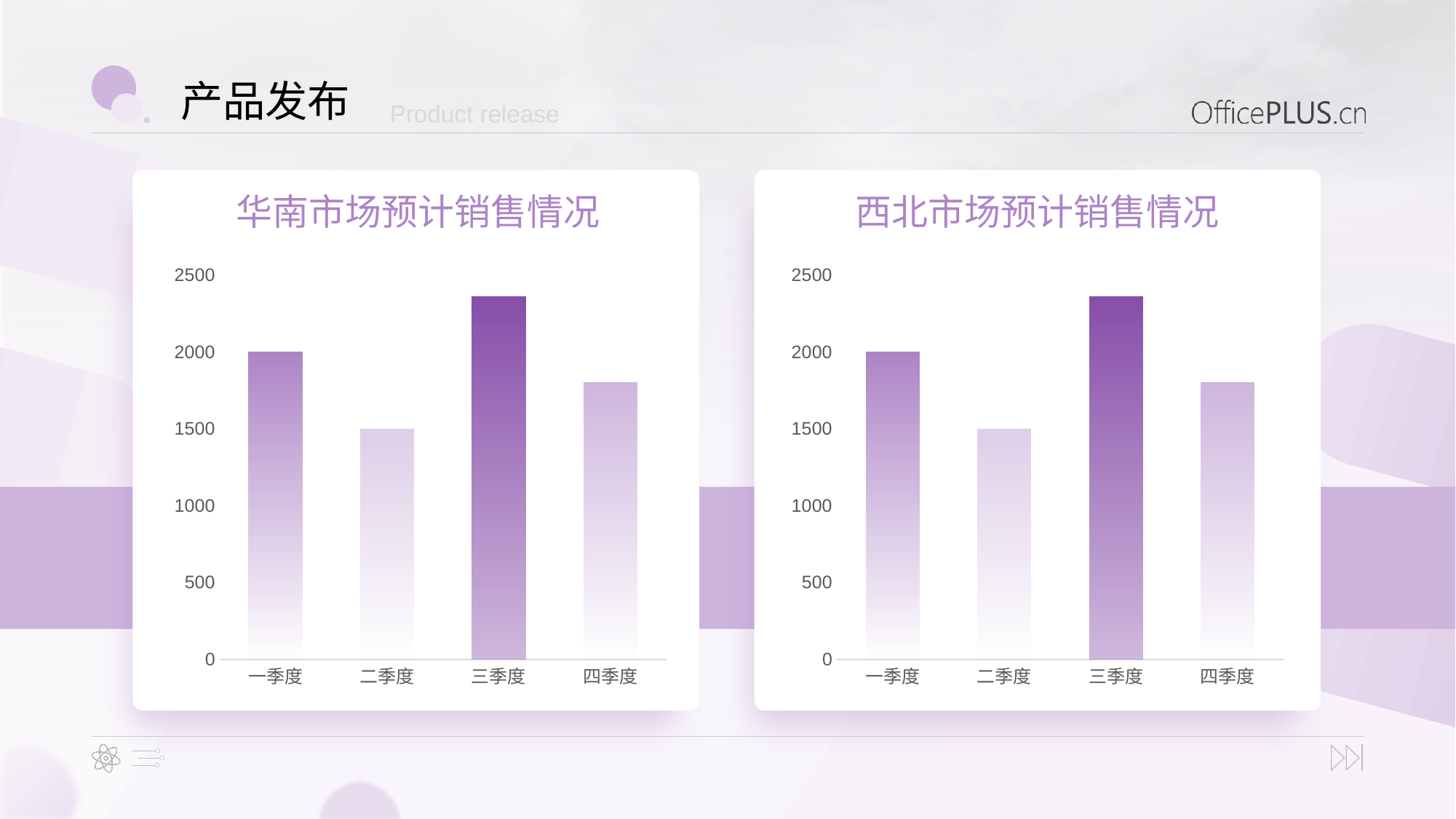
How many categories are shown on the x axis of the 西北市场预计销售情况 chart? 4 In the 华南市场预计销售情况 chart, is the value for 二季度 greater or less than 2000? less What is the highest value shown on the y axis of the 西北市场预计销售情况 chart? 2500 What is the title of the chart on the left side of the slide? 华南市场预计销售情况 In the 西北市场预计销售情况 chart, which is larger, the value for 一季度 or the value for 四季度? 一季度 What type of chart is the 华南市场预计销售情况 chart? bar chart In the 华南市场预计销售情况 chart, which is larger, the value for 二季度 or the value for 三季度? 三季度 In the 华南市场预计销售情况 chart, which quarter has the lowest value? 二季度 In the 华南市场预计销售情况 chart, which quarter has the highest value? 三季度 In the 西北市场预计销售情况 chart, is the value for 三季度 greater or less than 2000? greater In the 西北市场预计销售情况 chart, which quarter has the highest value? 三季度 In the 西北市场预计销售情况 chart, is the value for 四季度 greater or less than 2000? less